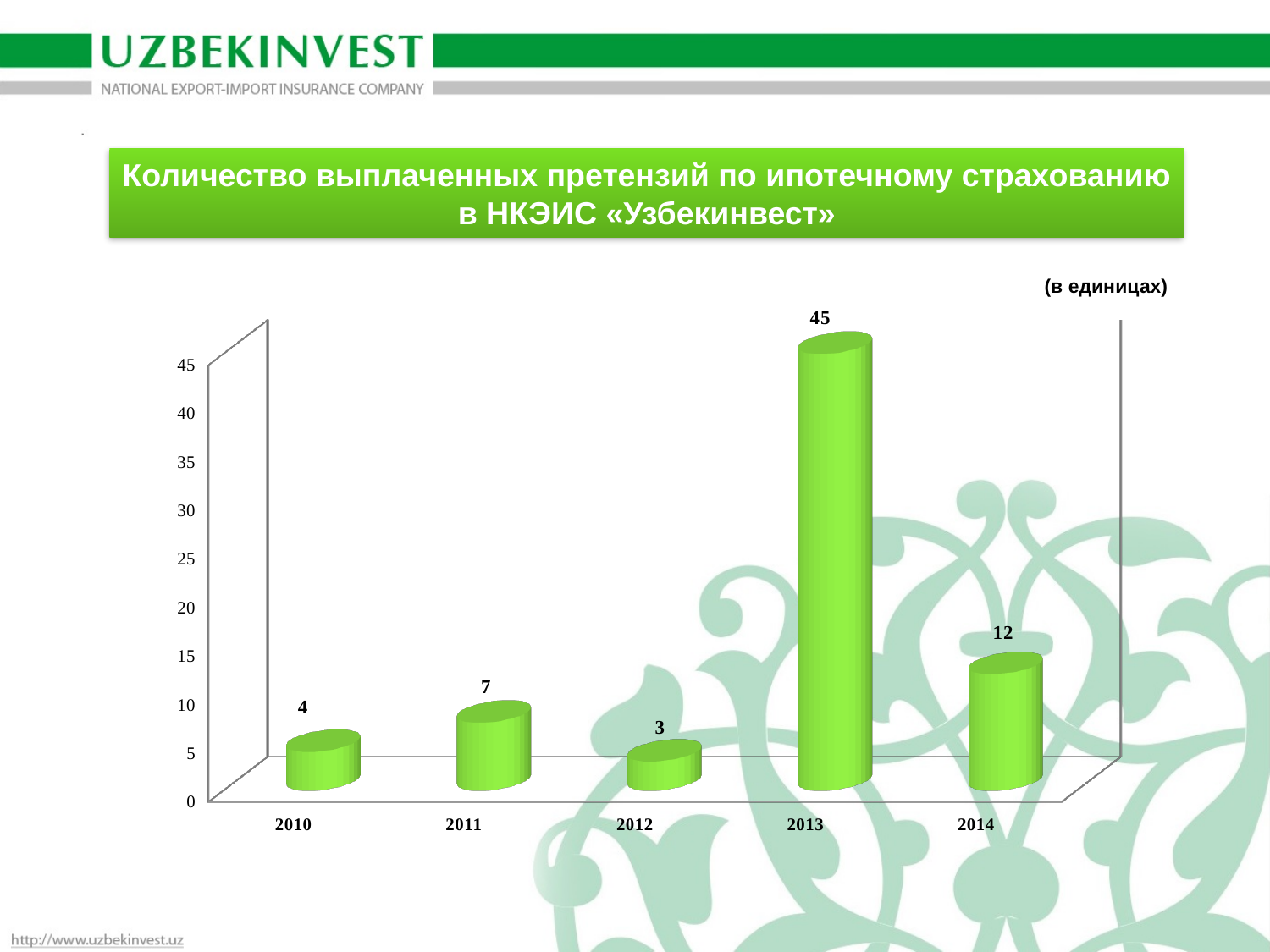
What is the value for 2010? 4 What is the difference between the values for 2011 and 2010? 3 What is the value for 2013? 45 Which year has the lowest value? 2012 Which is larger, the value for 2011 or the value for 2012? 2011 What kind of chart is shown on the slide? bar chart How many years are shown on the x axis? 5 What is the value for 2014? 12 What is the difference between the values for 2013 and 2014? 33 Do the values rise or fall from 2013 to 2014? fall Which year has the highest value? 2013 What unit is indicated in the label above the chart? в единицах